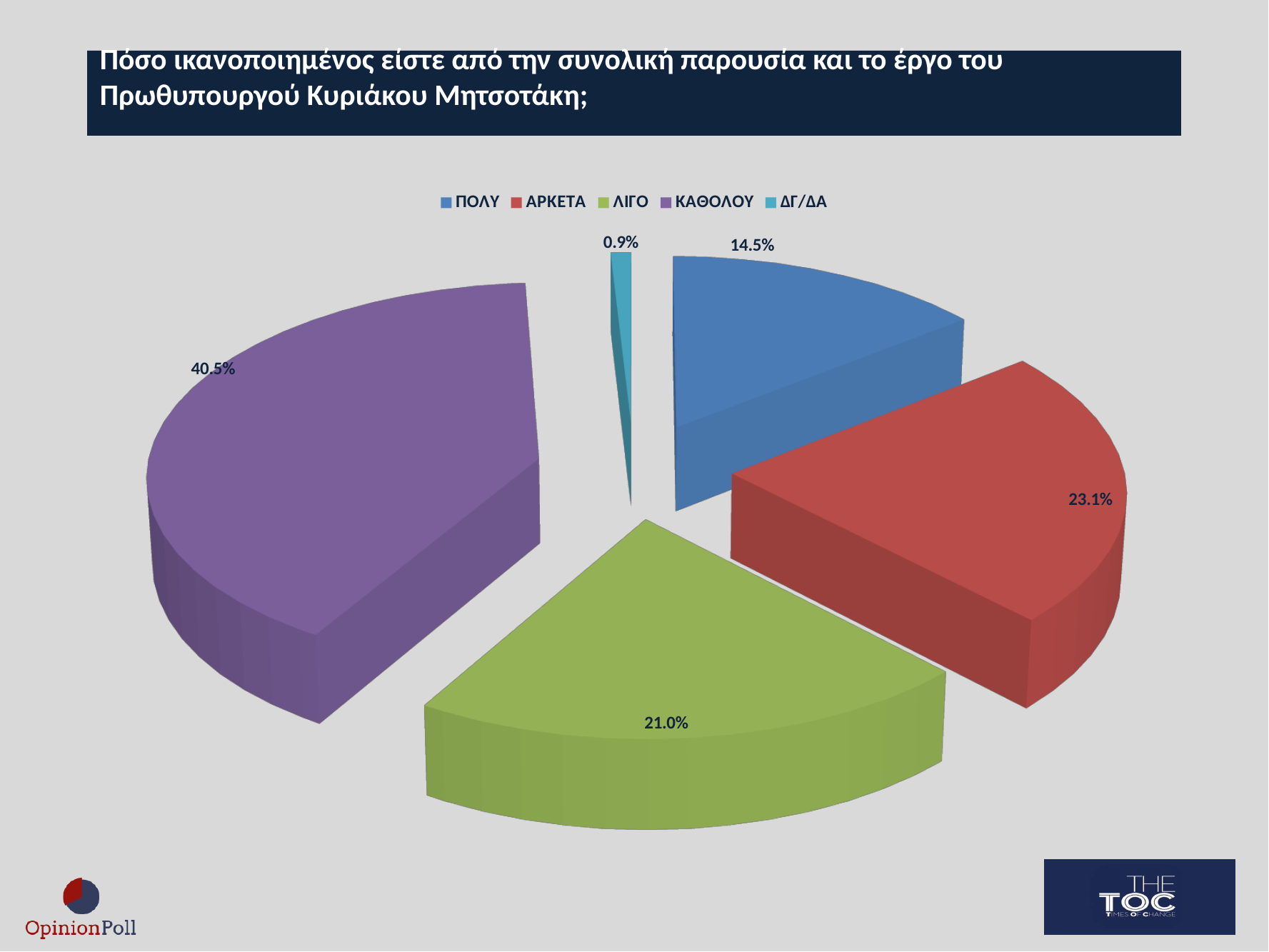
How many categories does the legend list? 5 What kind of chart is shown on the slide? Pie chart What percentage is shown for ΛΙΓΟ? 21.0% What percentage is shown for ΚΑΘΟΛΟΥ? 40.5% What is the difference in percentage points between ΚΑΘΟΛΟΥ and ΑΡΚΕΤΑ? 17.4 Which category has the smallest share of the pie? ΔΓ/ΔΑ Which is larger, the share for ΑΡΚΕΤΑ or the share for ΛΙΓΟ? ΑΡΚΕΤΑ What colour is the slice for ΚΑΘΟΛΟΥ? Purple What percentage is shown for ΑΡΚΕΤΑ? 23.1% What percentage is shown for ΠΟΛΥ? 14.5% Which category has the largest share of the pie? ΚΑΘΟΛΟΥ What percentage is shown for ΔΓ/ΔΑ? 0.9%